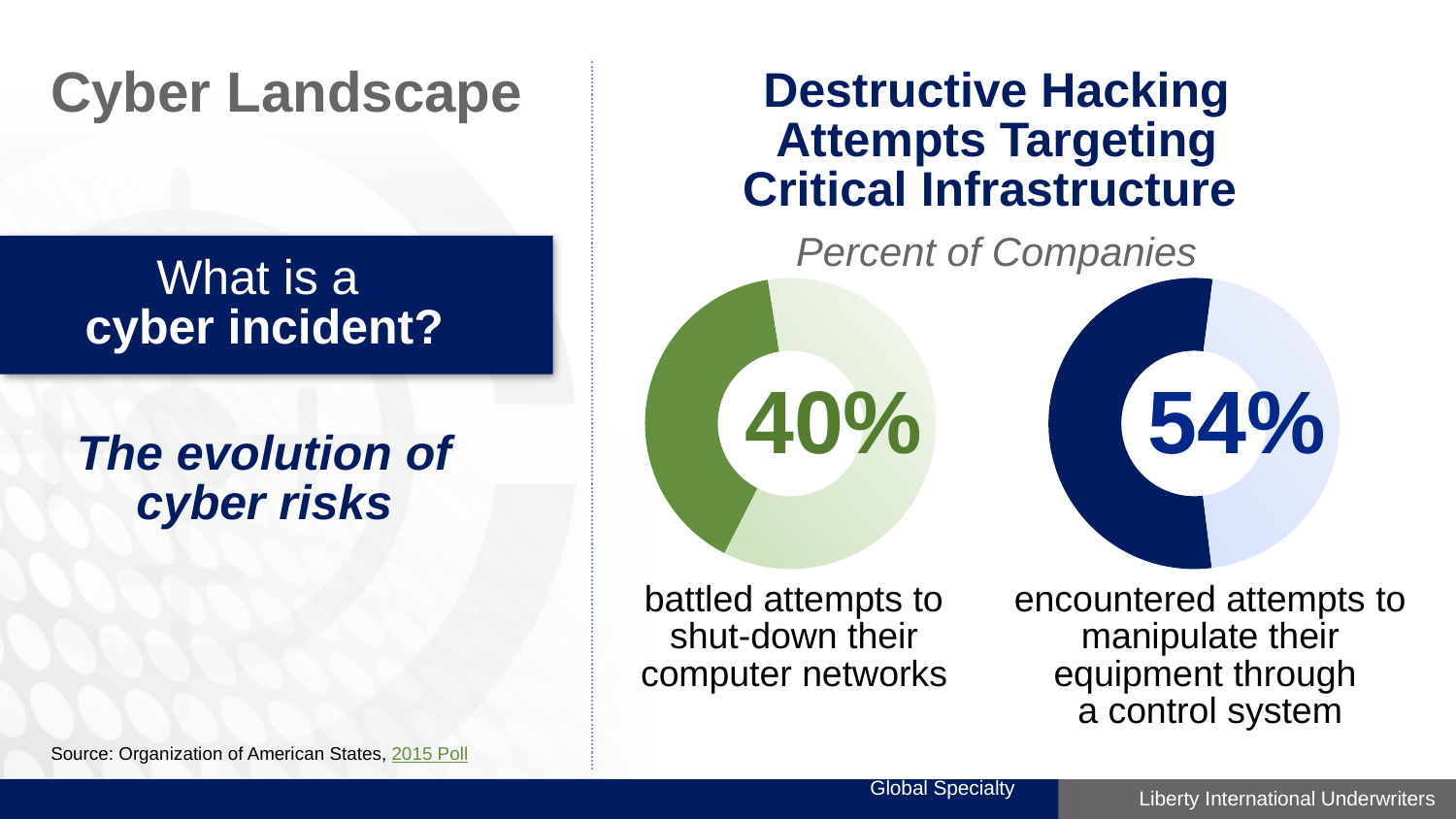
Is the value shown in the left donut chart greater or less than 50%? less In the left donut chart, what percent of companies battled attempts to shut down their computer networks? 40% What colour is the highlighted segment of the left donut chart showing 40%? Green What is the title above the two donut charts? Destructive Hacking Attempts Targeting Critical Infrastructure How many donut charts are shown on the slide? 2 What is the difference in percentage points between the value in the right donut chart (54%) and the value in the left donut chart (40%)? 14 percentage points Is the value shown in the right donut chart greater or less than 50%? greater Of the two donut charts on the slide, which shows the lower percentage? The left chart (40%) Of the two donut charts on the slide, which shows the higher percentage? The right chart (54%) What kind of chart is used to display the 40% and 54% figures on the slide? Donut (pie) charts In the right donut chart, what percent of companies encountered attempts to manipulate their equipment through a control system? 54% Which is larger: the percentage of companies that battled attempts to shut down their computer networks, or the percentage that encountered attempts to manipulate their equipment through a control system? Encountered attempts to manipulate their equipment through a control system (54%)